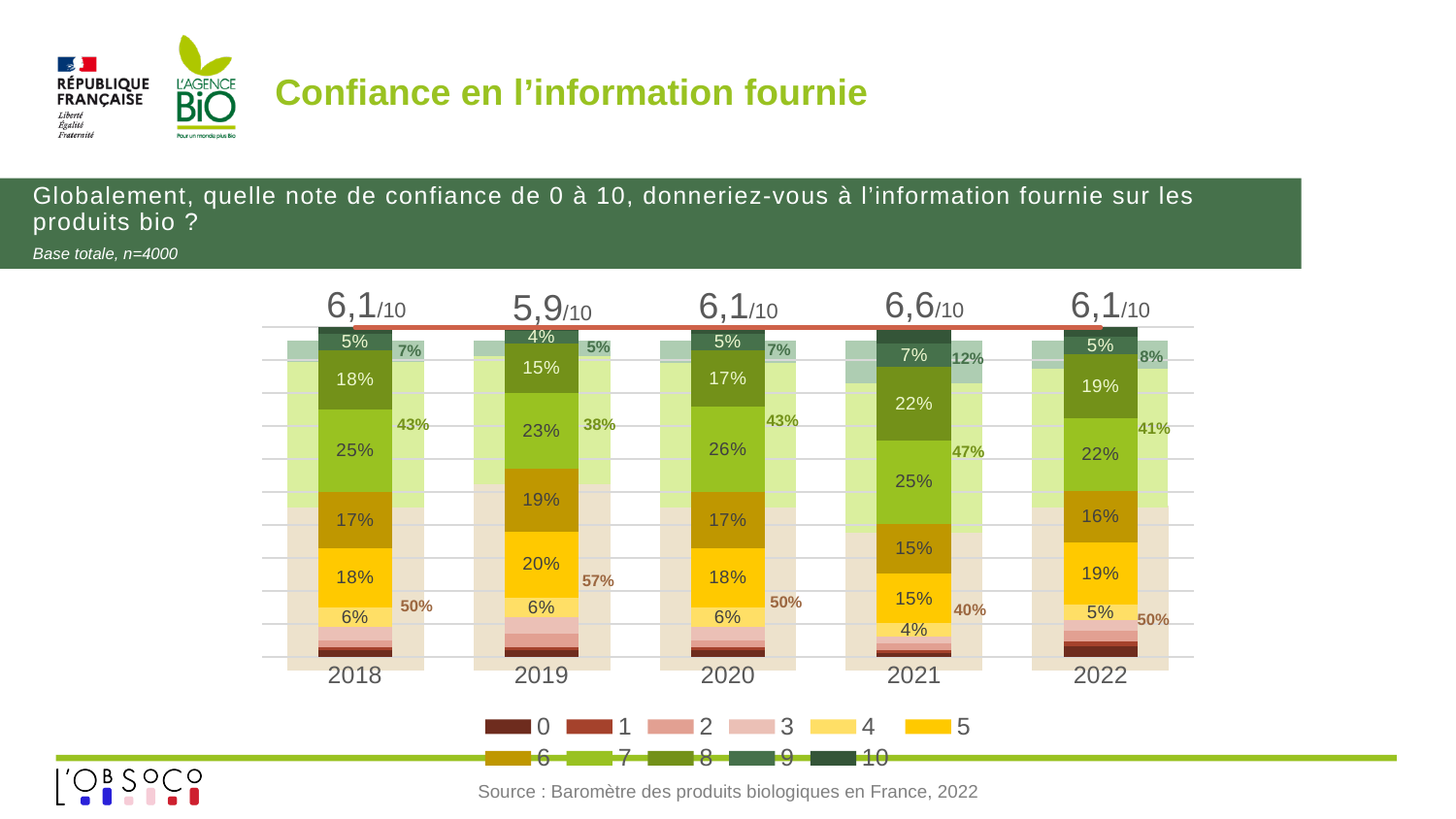
What percentage of respondents gave a score of 7 in 2020? 26% How many series does the legend list? 11 Which year has the larger share of respondents giving a score of 8: 2018 or 2021? 2021 Which year has the lowest average confidence score shown above the bars? 2019 What percentage of respondents gave a score of 5 in 2019? 20% Which year has the highest average confidence score shown above the bars? 2021 What is the grouped percentage shown to the right of the bottom (yellow/brown) segments of the 2019 bar? 57% What is the grouped percentage shown to the right of the top (dark green) segments of the 2021 bar? 12% What percentage of respondents gave a score of 6 in 2022? 16% What average confidence score is shown above the 2021 bar? 6,6/10 How many years are shown on the x axis? 5 What kind of chart is shown on the slide? Stacked bar chart